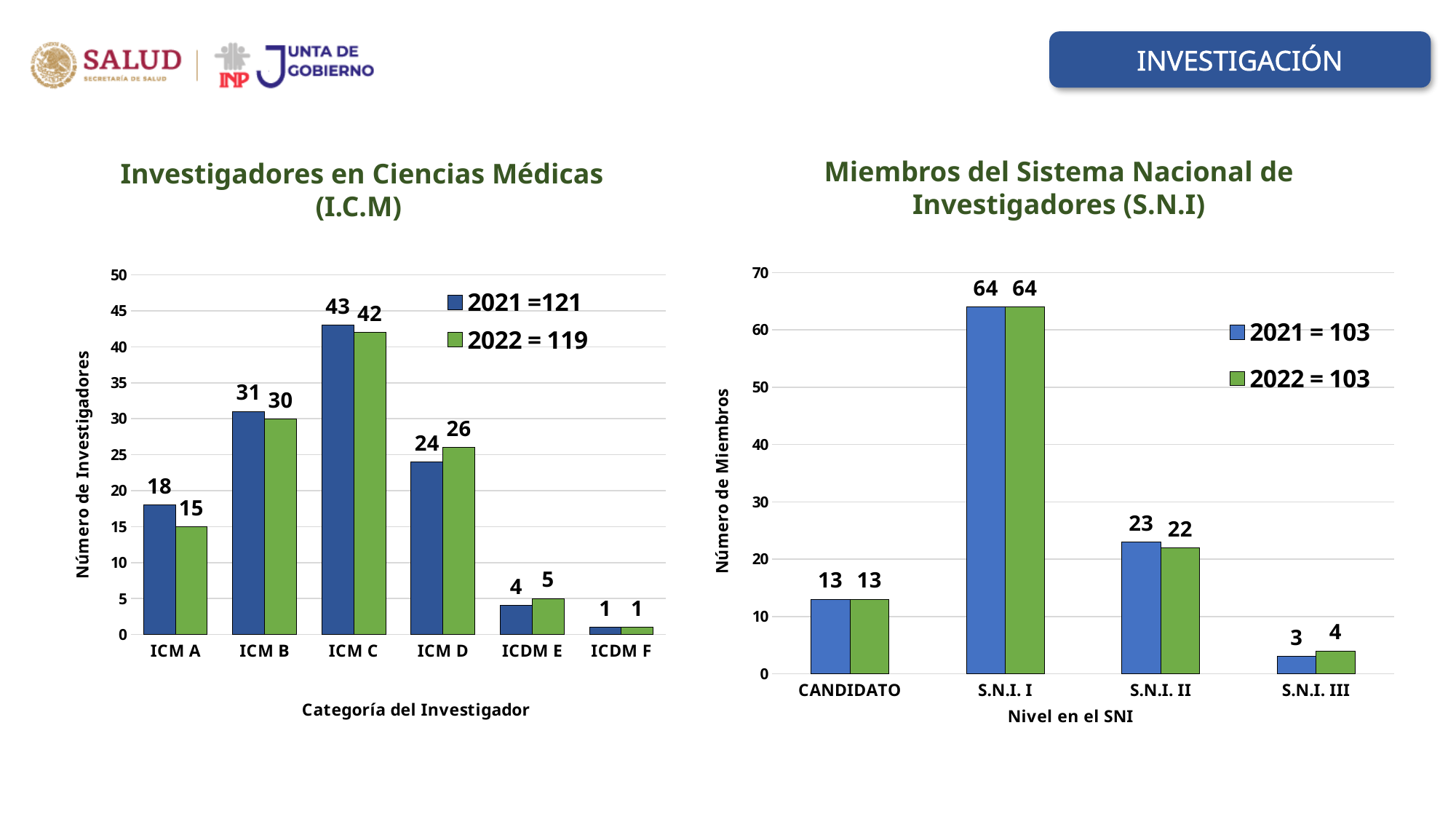
In the 'Miembros del Sistema Nacional de Investigadores (S.N.I)' chart, is the 2022 value for S.N.I. II larger or smaller than the 2022 value for CANDIDATO? larger In the 'Investigadores en Ciencias Médicas (I.C.M)' chart, which category has the highest value in 2022? ICM C In the 'Investigadores en Ciencias Médicas (I.C.M)' chart, what is the difference between the 2021 and 2022 values for ICM A? 3 In the 'Miembros del Sistema Nacional de Investigadores (S.N.I)' chart, how many series does the legend list? 2 In the 'Investigadores en Ciencias Médicas (I.C.M)' chart, how many categories are shown on the x axis? 6 In the 'Investigadores en Ciencias Médicas (I.C.M)' chart, what is the value for ICM A in 2022? 15 In the 'Investigadores en Ciencias Médicas (I.C.M)' chart, what total does the legend give for 2021? 121 In the 'Miembros del Sistema Nacional de Investigadores (S.N.I)' chart, what is the value for S.N.I. III in 2022? 4 In the 'Miembros del Sistema Nacional de Investigadores (S.N.I)' chart, what is the value for S.N.I. II in 2021? 23 In the 'Investigadores en Ciencias Médicas (I.C.M)' chart, what is the value for ICM C in 2021? 43 In the 'Miembros del Sistema Nacional de Investigadores (S.N.I)' chart, which level has the lowest value in 2021? S.N.I. III What kind of chart is the 'Miembros del Sistema Nacional de Investigadores (S.N.I)' chart? bar chart